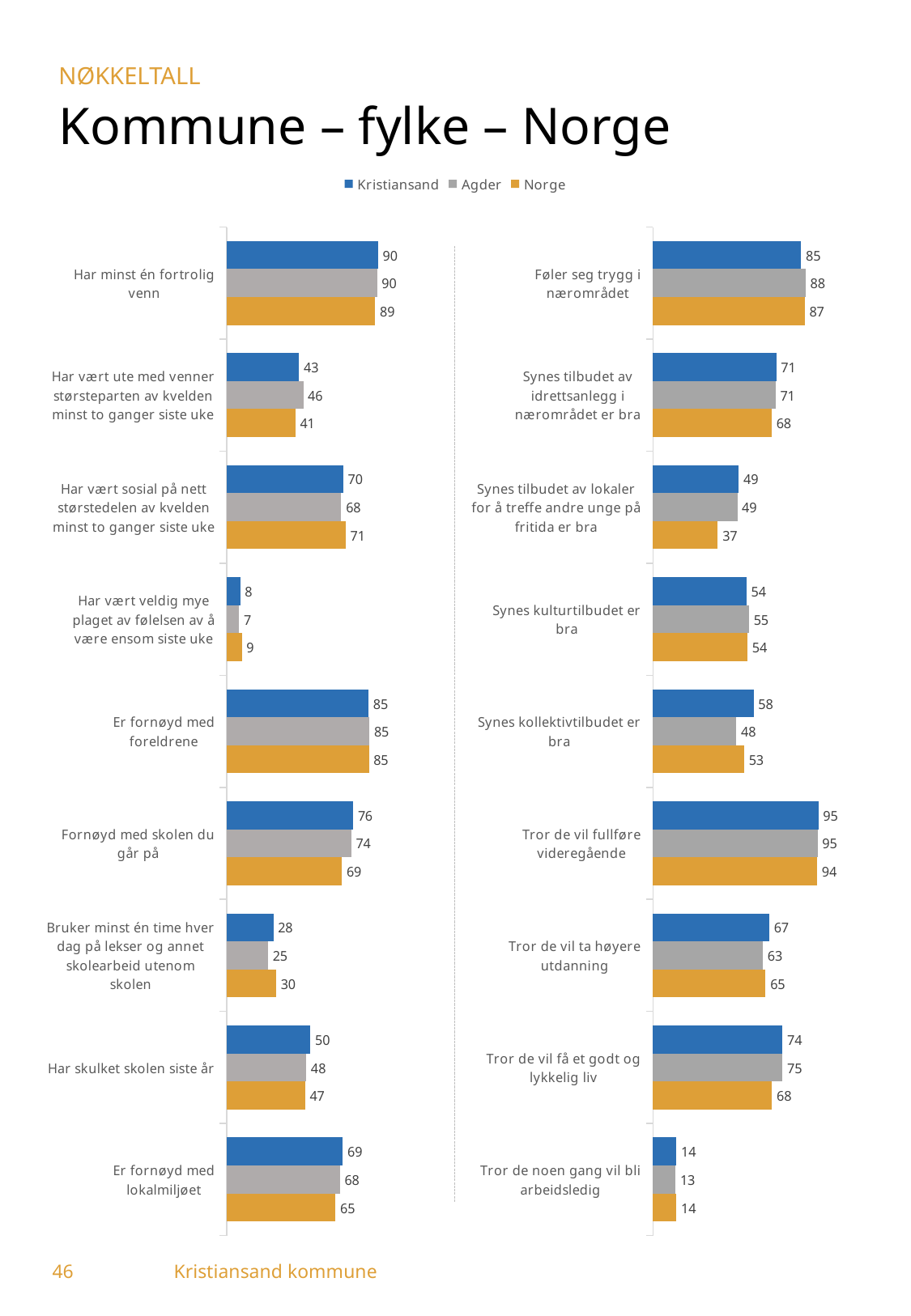
In the right chart, which category has the highest value for Kristiansand? Tror de vil fullføre videregående In the left chart, which is larger for "Fornøyd med skolen du går på": Kristiansand or Norge? Kristiansand In the right chart, what is the value for Norge for "Synes tilbudet av lokaler for å treffe andre unge på fritida er bra"? 37 What kind of chart is used on this slide? Bar chart In the left chart, what is the value for Kristiansand for "Har minst én fortrolig venn"? 90 How many categories are shown in the left chart? 9 In the left chart, what is the value for Agder for "Bruker minst én time hver dag på lekser og annet skolearbeid utenom skolen"? 25 Which colour represents Norge in the legend? Orange In the left chart, which category has the lowest value for Norge? Har vært veldig mye plaget av følelsen av å være ensom siste uke In the right chart, what is the difference between Kristiansand and Agder for "Synes kollektivtilbudet er bra"? 10 In the right chart, what is the value for Agder for "Tror de vil få et godt og lykkelig liv"? 75 How many series does the legend list? 3